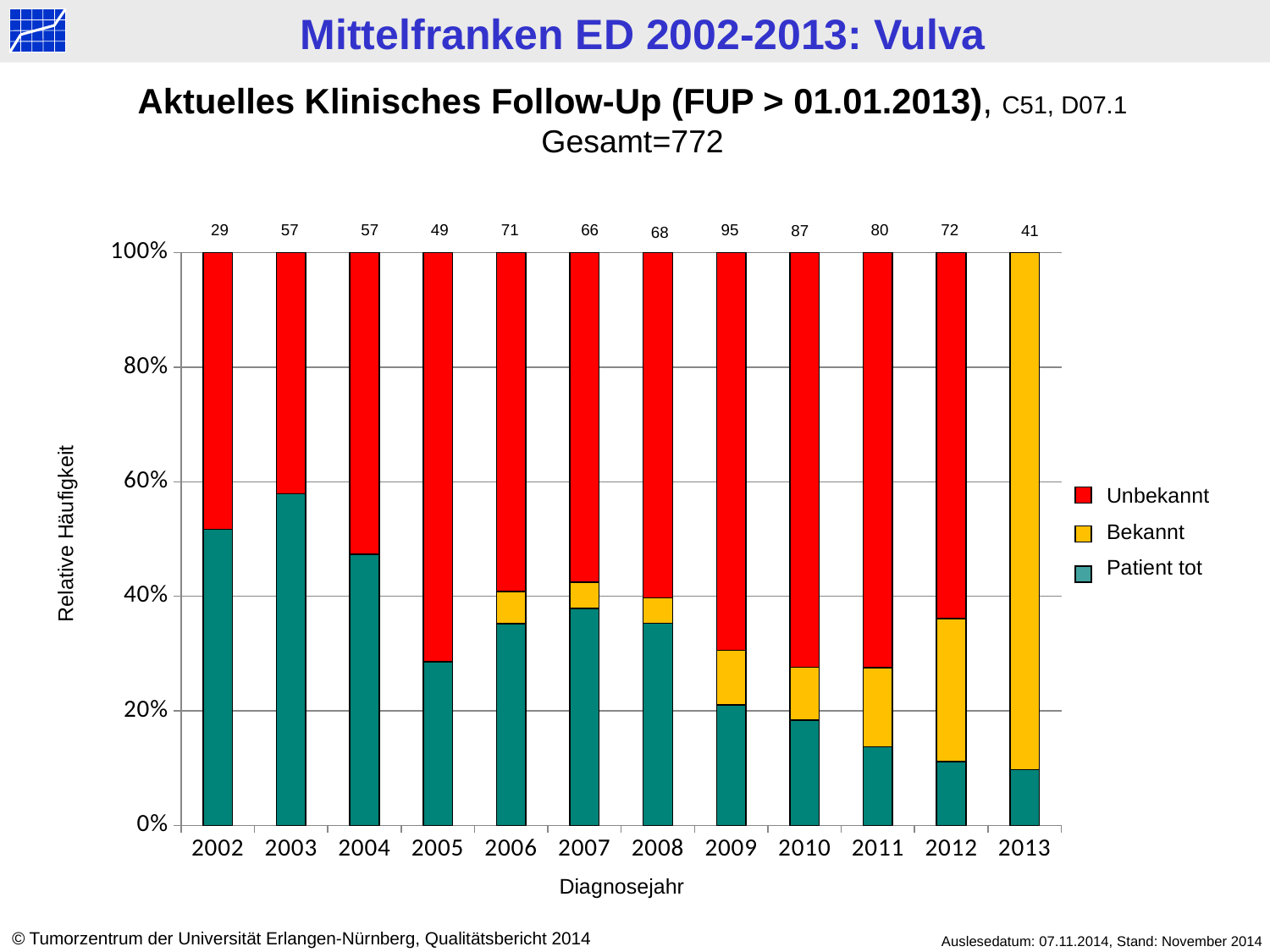
How many diagnosis years (Diagnosejahr) are shown on the x axis? 12 Which year has the larger number printed above its bar, 2010 or 2011? 2010 What is the number printed above the bar for 2002? 29 What is the number printed above the bar for 2013? 41 Which year has the lowest number printed above its bar? 2002 Which year has the highest number printed above its bar? 2009 Does the 'Patient tot' share rise or fall from 2009 to 2013? fall How many series does the legend list? 3 Is the 'Patient tot' share for 2003 greater or less than 40%? greater What is the difference between the numbers printed above the bars for 2009 and 2002? 66 What is the number printed above the bar for 2009? 95 What kind of chart is shown on the slide? bar chart